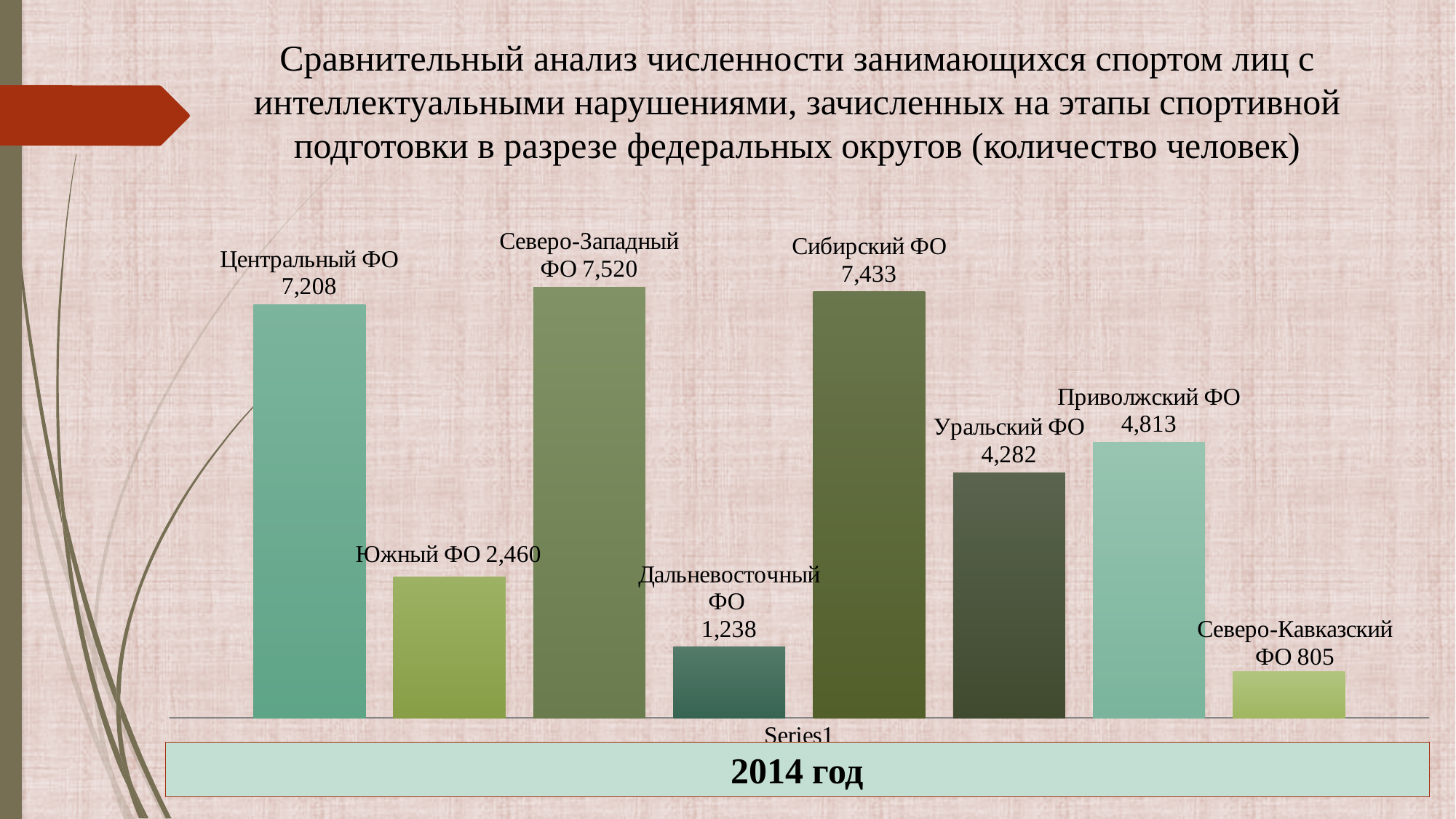
Which federal district has the lowest value? Северо-Кавказский ФО Which is larger, the value for Южный ФО or the value for Дальневосточный ФО? Южный ФО What is the value for Центральный ФО? 7,208 Which is larger, the value for Сибирский ФО or the value for Центральный ФО? Сибирский ФО How many federal districts are shown in the chart? 8 What is the difference between the values for Южный ФО and Дальневосточный ФО? 1,222 What is the value for Уральский ФО? 4,282 What is the difference between the values for Приволжский ФО and Уральский ФО? 531 What year is shown in the label below the chart? 2014 год What is the value for Северо-Кавказский ФО? 805 Which federal district has the highest value? Северо-Западный ФО What kind of chart is shown on the slide? Bar chart